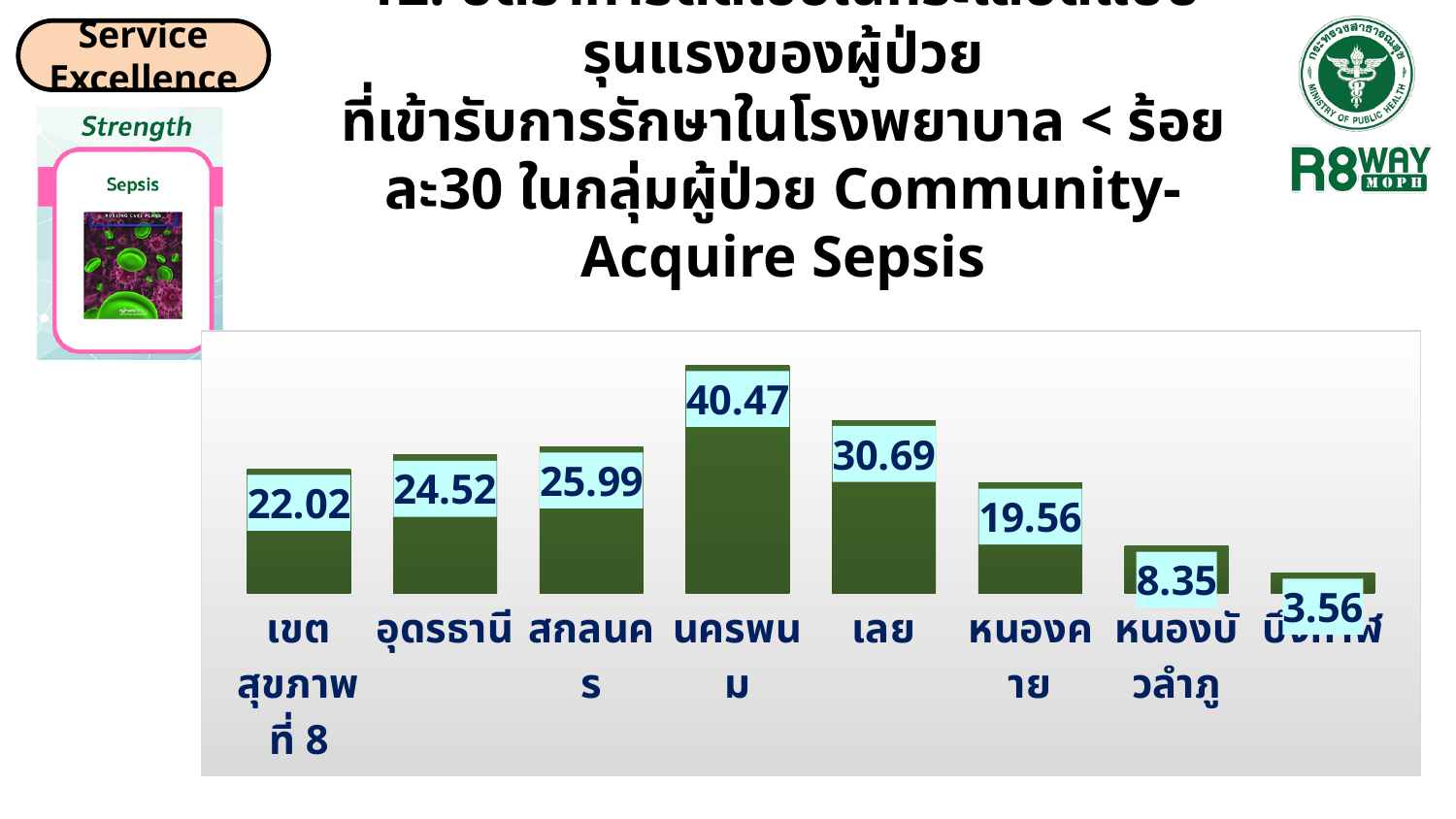
What is the value for หนองบัวลำภู? 8.35 What is the difference between the values for นครพนม and เลย? 9.78 What kind of chart is shown on the slide? bar chart Which is larger, the value for อุดรธานี or the value for หนองคาย? อุดรธานี How many categories are shown in the chart? 8 What is the value for หนองคาย? 19.56 What is the difference between the values for สกลนคร and อุดรธานี? 1.47 Which category has the highest value? นครพนม What is the value for นครพนม? 40.47 What is the value for บึงกาฬ? 3.56 What is the value for เขตสุขภาพที่ 8? 22.02 Which category has the lowest value? บึงกาฬ